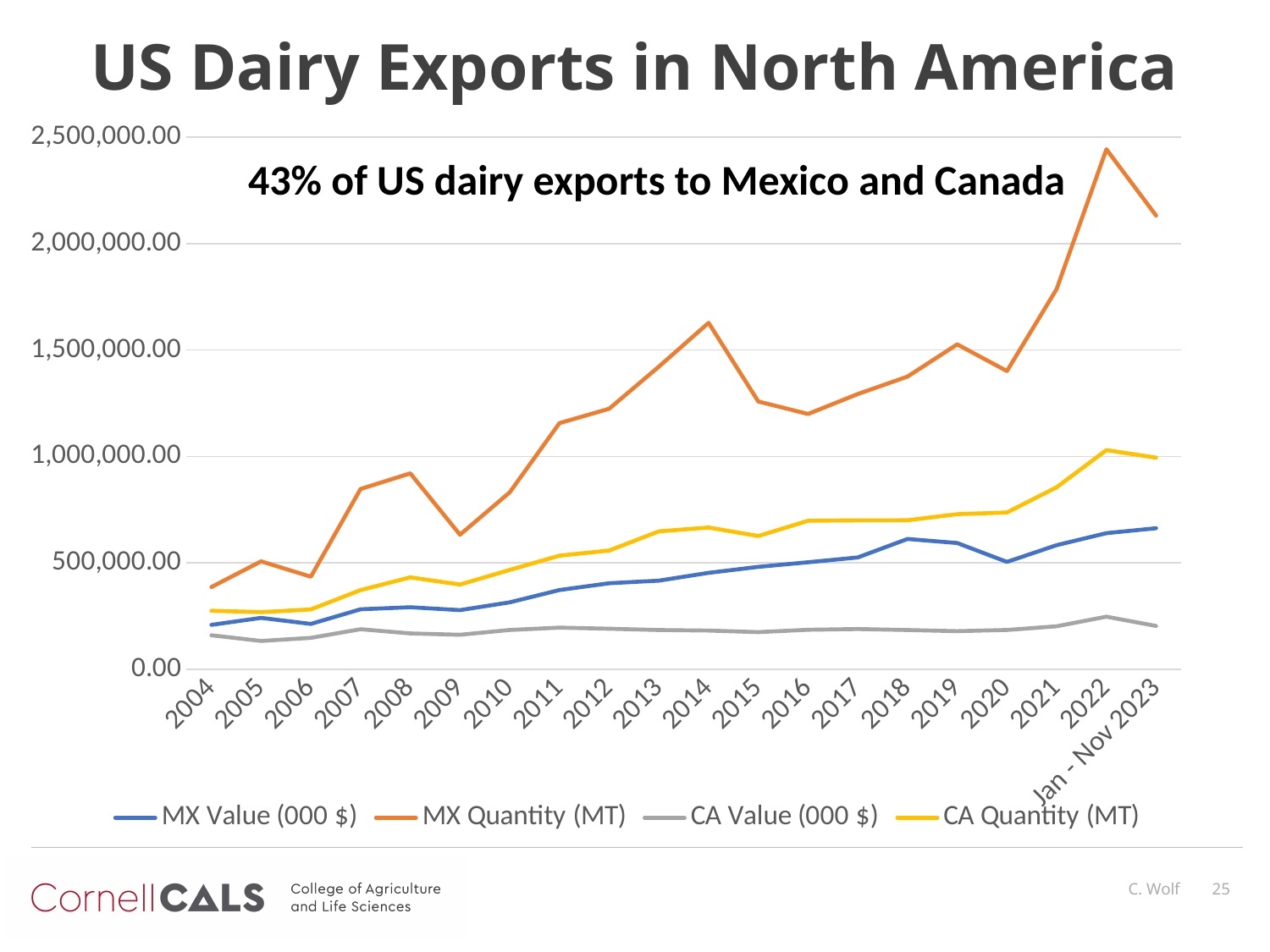
How many series does the legend list? 4 What kind of chart is shown on the slide? Line chart What is the title of the chart? US Dairy Exports in North America In 2022, which is larger: MX Quantity (MT) or CA Quantity (MT)? MX Quantity (MT) In which year does MX Quantity (MT) reach its highest value? 2022 Which series stays lowest across the whole chart? CA Value (000 $) Does CA Quantity (MT) generally rise or fall from 2004 to 2022? Rise Is the value for MX Value (000 $) in 2004 greater or less than 500,000.00? less Is the value for MX Quantity (MT) in 2022 greater or less than 2,000,000.00? greater Is the value for MX Quantity (MT) in 2009 greater or less than 1,000,000.00? less How many points are plotted along the x axis for each series? 20 Which is larger for MX Value (000 $): the value in 2018 or the value in 2020? 2018